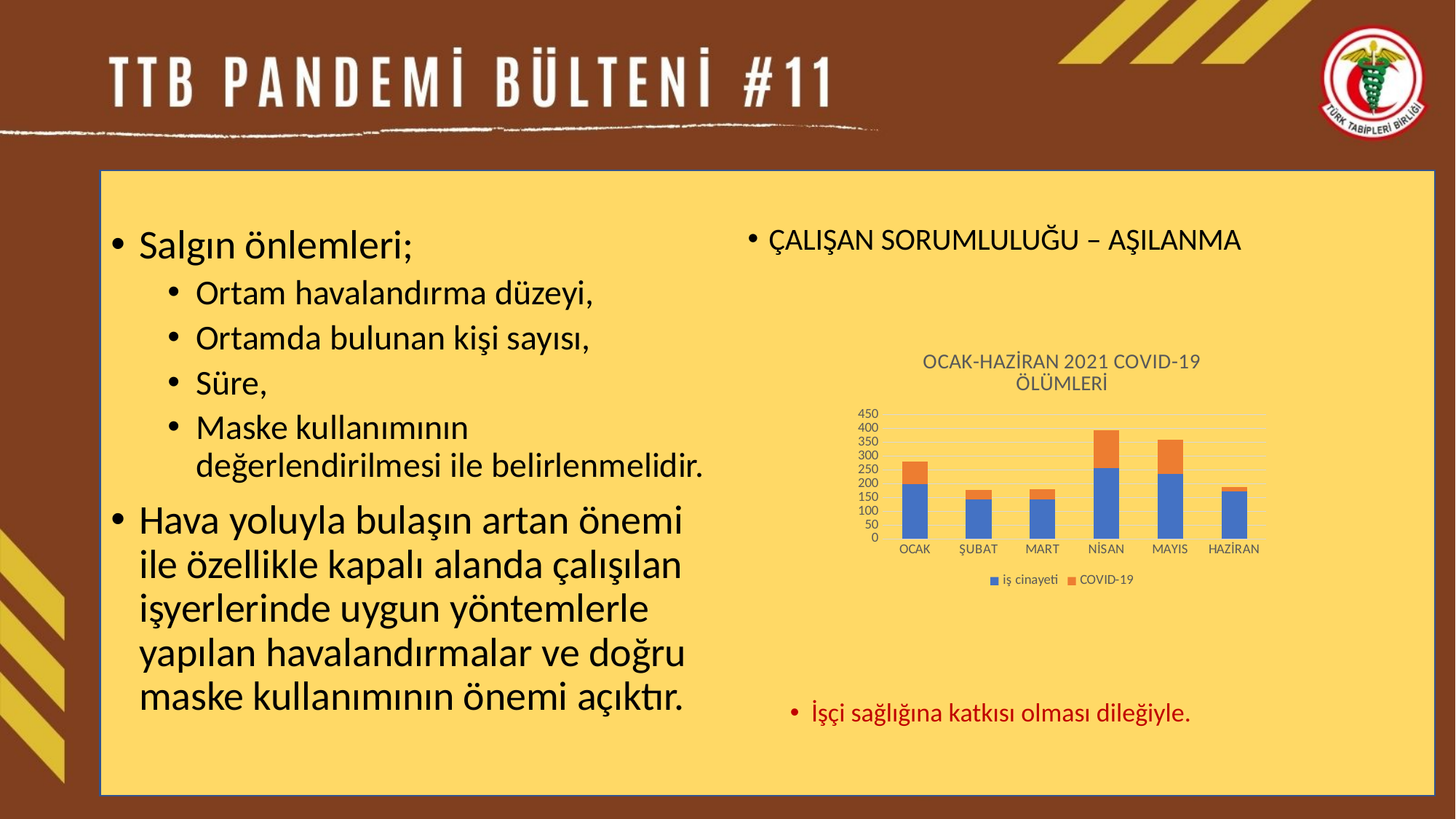
Is the total bar for ŞUBAT greater or less than 200? less Is the 'iş cinayeti' value for MAYIS greater or less than 200? greater What is the title of the chart? OCAK-HAZİRAN 2021 COVID-19 ÖLÜMLERİ Which series is shown in orange in the chart? COVID-19 How many months (categories) are shown on the x axis of the chart? 6 Is the total bar for OCAK greater or less than 250? greater Which month has the tallest 'iş cinayeti' segment in the chart? NİSAN Which has the larger total bar, OCAK or ŞUBAT? OCAK How many series does the chart's legend list? 2 Which month has the highest total bar in the chart? NİSAN What kind of chart is shown on the slide? Stacked bar chart